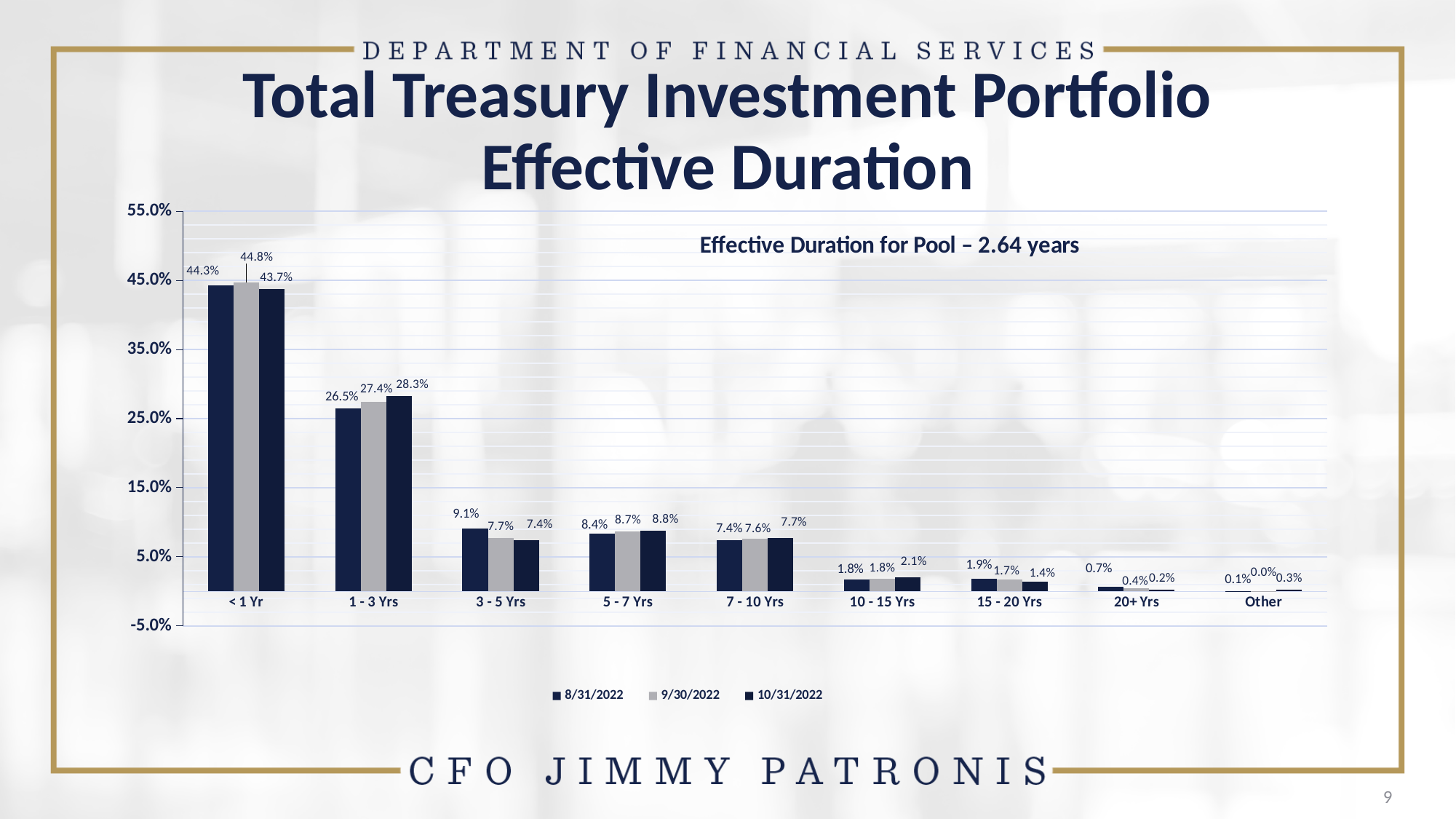
What is the value for the 3 - 5 Yrs category in the 8/31/2022 series? 9.1% Which category has the lowest value in the 9/30/2022 series? Other How many series does the legend list? 3 What is the difference between the 10/31/2022 and 8/31/2022 values for the 1 - 3 Yrs category? 1.8% What is the value for the 1 - 3 Yrs category in the 10/31/2022 series? 28.3% How many maturity categories are shown on the x axis? 9 Which category has the highest value in the 10/31/2022 series? < 1 Yr What effective duration for the pool is stated on the chart? 2.64 years What is the value for the < 1 Yr category in the 9/30/2022 series? 44.8% What is the value for the 20+ Yrs category in the 10/31/2022 series? 0.2% For the 3 - 5 Yrs category, which series has the larger value: 8/31/2022 or 10/31/2022? 8/31/2022 What kind of chart is shown on the slide? Bar chart